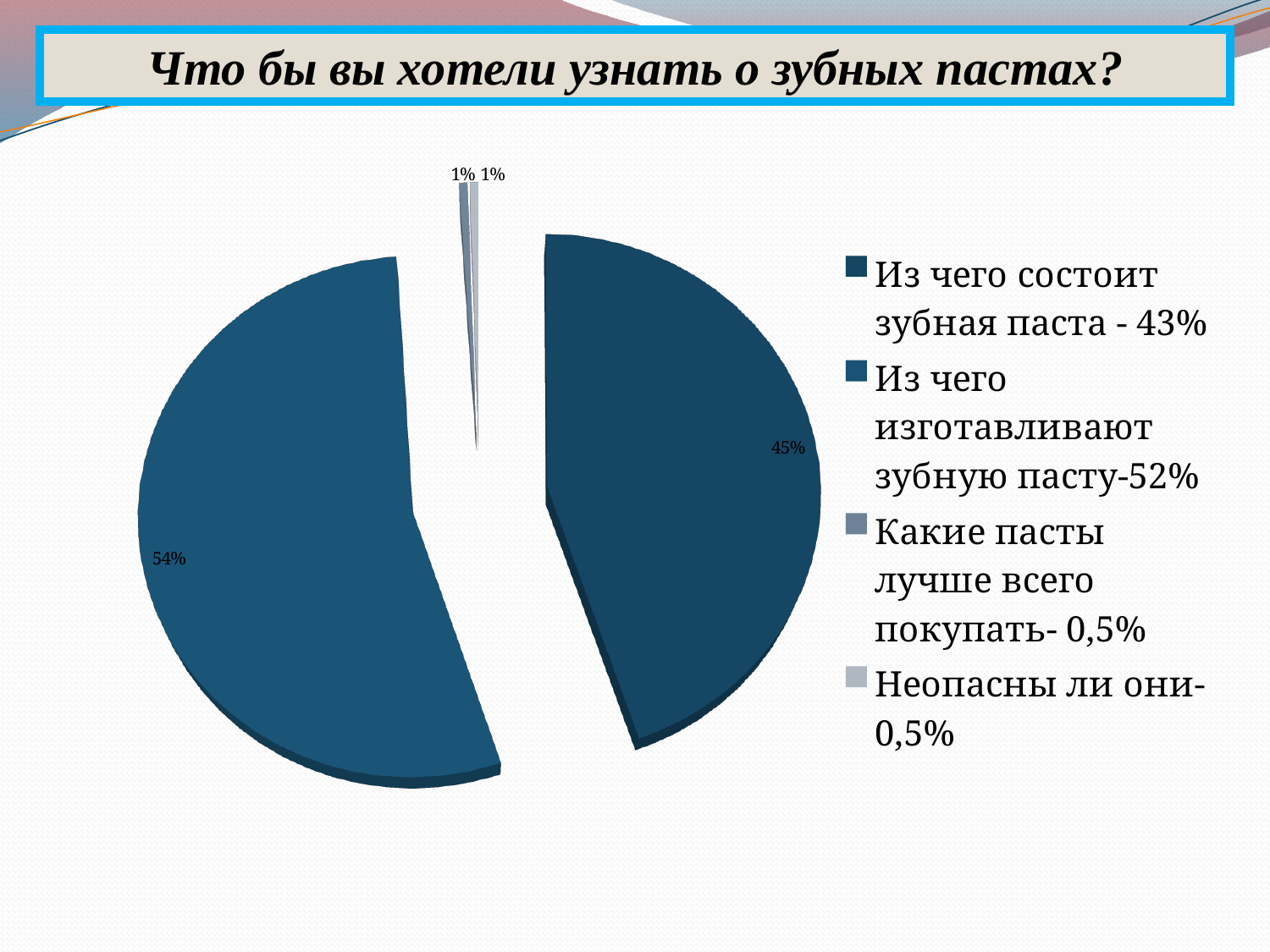
What is the title of the chart on the slide? Что бы вы хотели узнать о зубных пастах? What is the data label on the large slice on the left side of the pie chart? 54% How many entries does the legend of the pie chart list? 4 Is the data label on the left large slice of the pie chart greater or less than 50%? greater What is the data label on the largest slice of the pie chart? 54% How many slices does the pie chart have? 4 What is the difference between the data labels of the two large slices (54% and 45%)? 9 percentage points What type of chart is shown on the slide? pie chart Which is larger, the left large slice or the right large slice of the pie chart? the left slice (54%) What is the data label on the large slice on the right side of the pie chart? 45% What data label is shown on each of the two smallest slices of the pie chart? 1% Which legend entry of the pie chart is listed first? Из чего состоит зубная паста - 43%